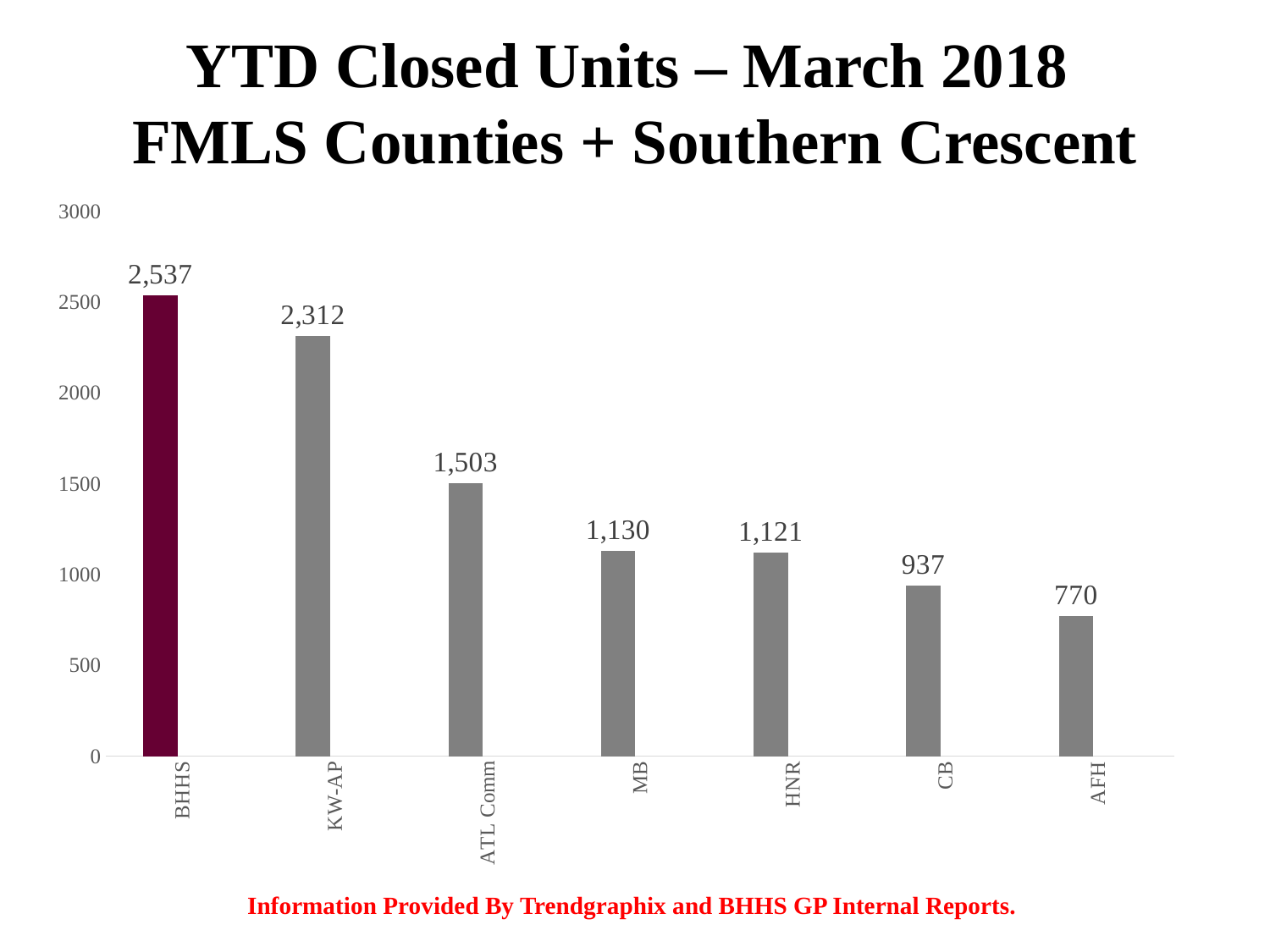
Which bar is shown in a different colour from the others? BHHS What is the YTD closed units value for ATL Comm? 1,503 What kind of chart is shown on the slide? Bar chart How many companies are shown on the chart? 7 What is the YTD closed units value for CB? 937 Is the value for KW-AP greater or less than 2000? greater Which company has the highest YTD closed units? BHHS Which company has the lowest YTD closed units? AFH What is the difference in YTD closed units between MB and HNR? 9 Which has more YTD closed units, ATL Comm or CB? ATL Comm What is the YTD closed units value for BHHS? 2,537 What is the difference in YTD closed units between BHHS and KW-AP? 225